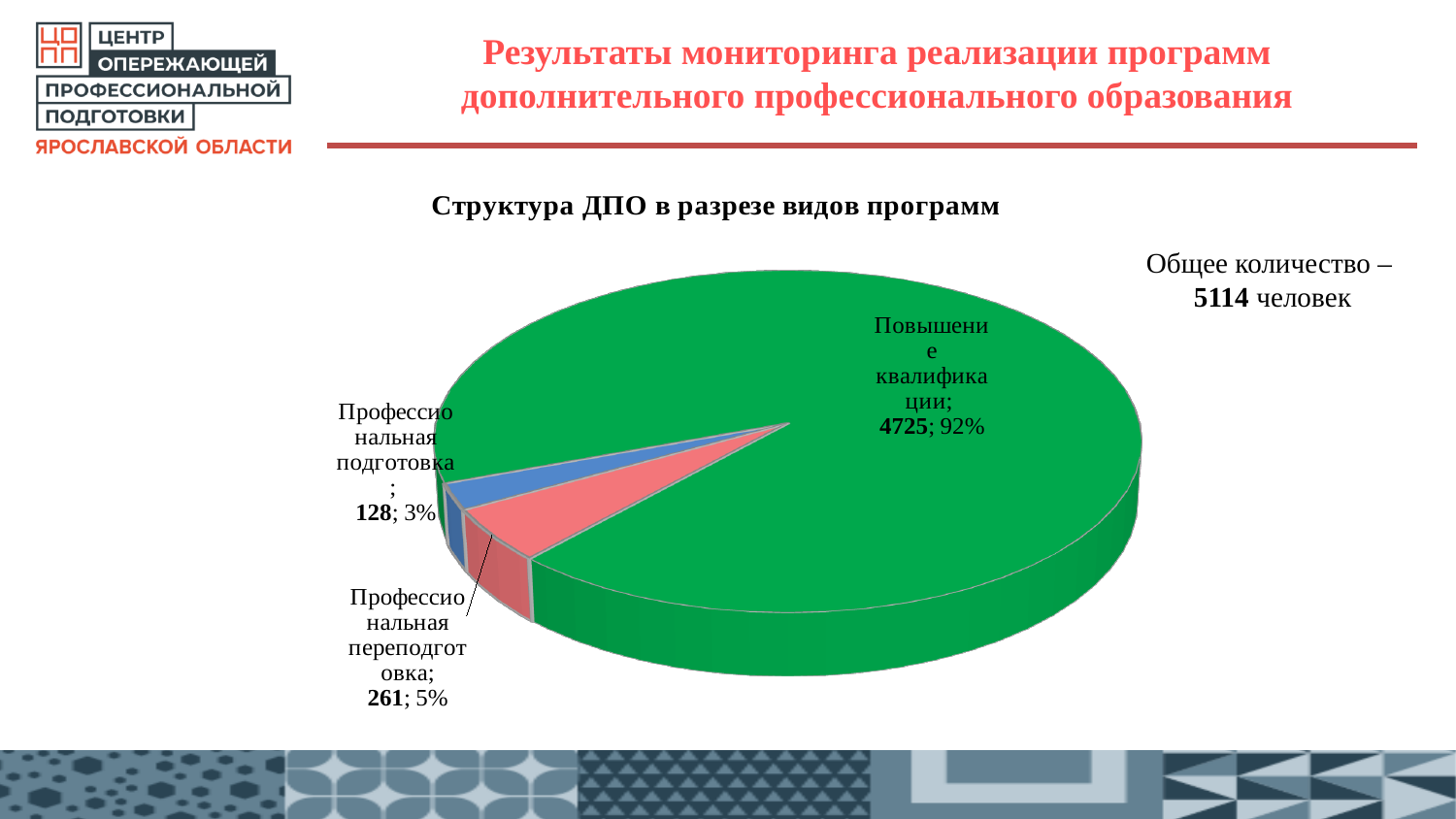
What is the value for Профессиональная подготовка? 128 What kind of chart is shown on the slide? pie chart What is the value for Профессиональная переподготовка? 261 Which is larger, Профессиональная переподготовка or Профессиональная подготовка? Профессиональная переподготовка What share of the pie does Профессиональная переподготовка take? 5% How many slices does the pie chart have? 3 Which category has the smallest slice? Профессиональная подготовка Which category has the largest slice? Повышение квалификации What is the title of the chart? Структура ДПО в разрезе видов программ What is the value for Повышение квалификации? 4725 What share of the pie does Повышение квалификации take? 92% What is the difference between the values for Профессиональная переподготовка and Профессиональная подготовка? 133